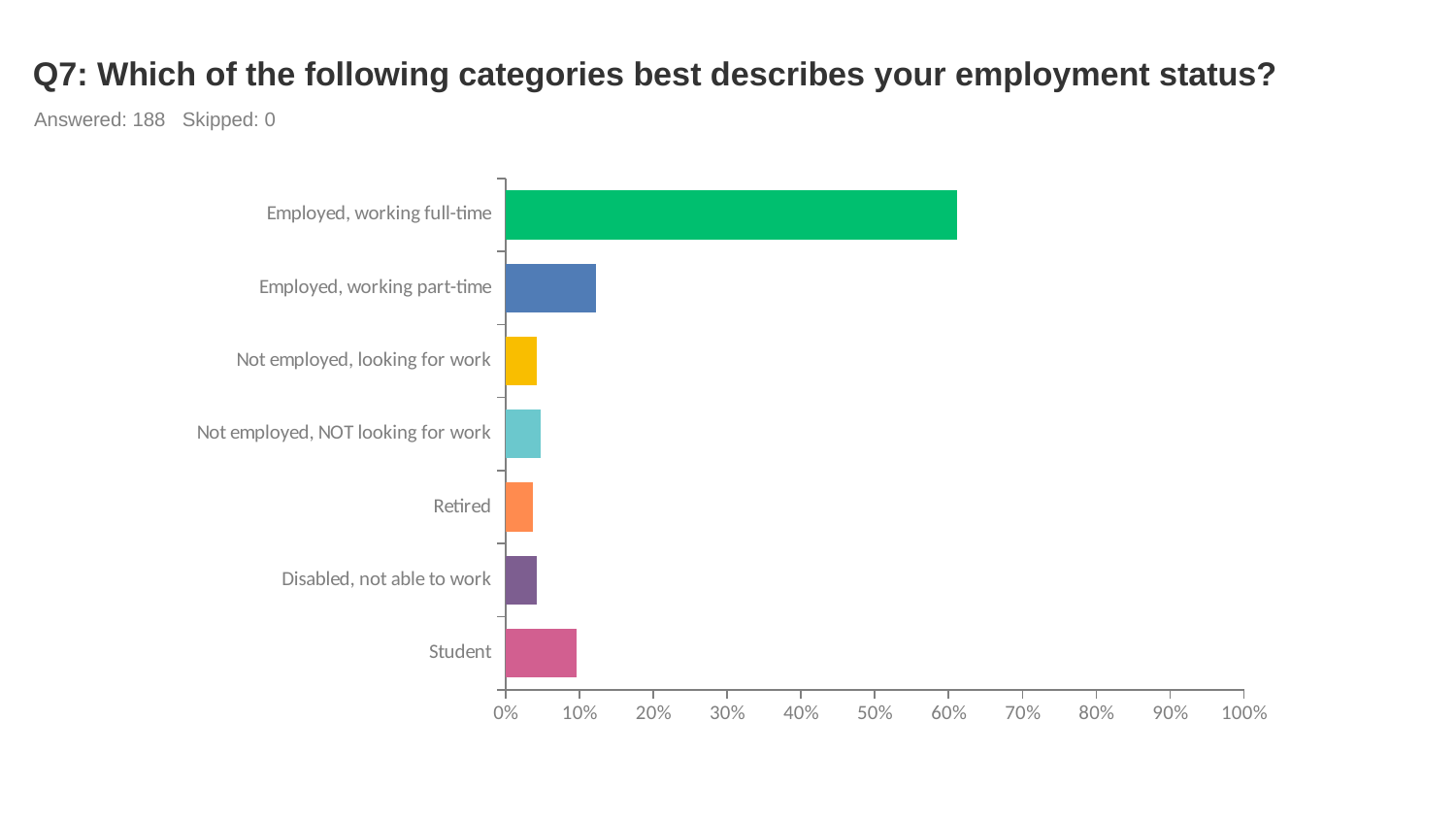
Is the value for Retired greater or less than 10%? less How many employment status categories are plotted in the chart? 7 Is the value for Not employed, NOT looking for work greater or less than 10%? less Which employment status category has the highest value? Employed, working full-time Is the value for Employed, working full-time greater or less than 50%? greater What kind of chart is shown on the slide? bar chart Which is larger, the value for Employed, working full-time or the value for Employed, working part-time? Employed, working full-time Which is larger, the value for Student or the value for Retired? Student What is the highest value shown on the horizontal axis of the chart? 100% How many respondents answered the question shown in the chart title? 188